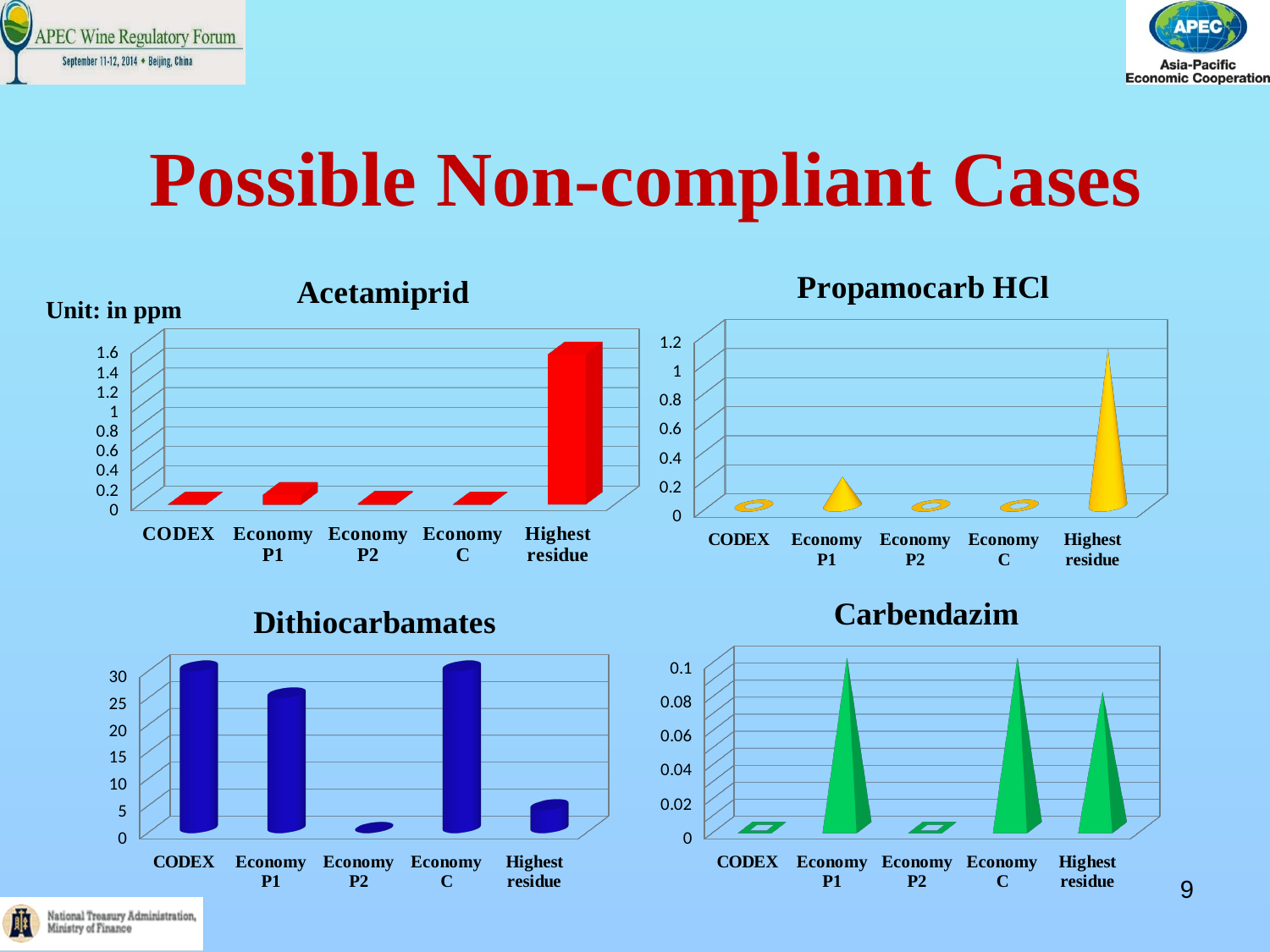
In the Dithiocarbamates chart, which is larger, the value for Economy P1 or the value for Highest residue? Economy P1 In the Propamocarb HCl chart, which category has the highest value? Highest residue In the Acetamiprid chart, which category has the highest value? Highest residue What unit is stated for the values in the charts on this slide? ppm In the Carbendazim chart, how many categories are shown on the x axis? 5 In the Acetamiprid chart, is the value for Highest residue greater or less than 1? greater In the Dithiocarbamates chart, which category has the lowest value? Economy P2 What kind of chart is the Dithiocarbamates chart? bar chart In the Propamocarb HCl chart, is the value for Highest residue greater or less than 0.8? greater In the Carbendazim chart, is the value for Highest residue greater or less than 0.06? greater